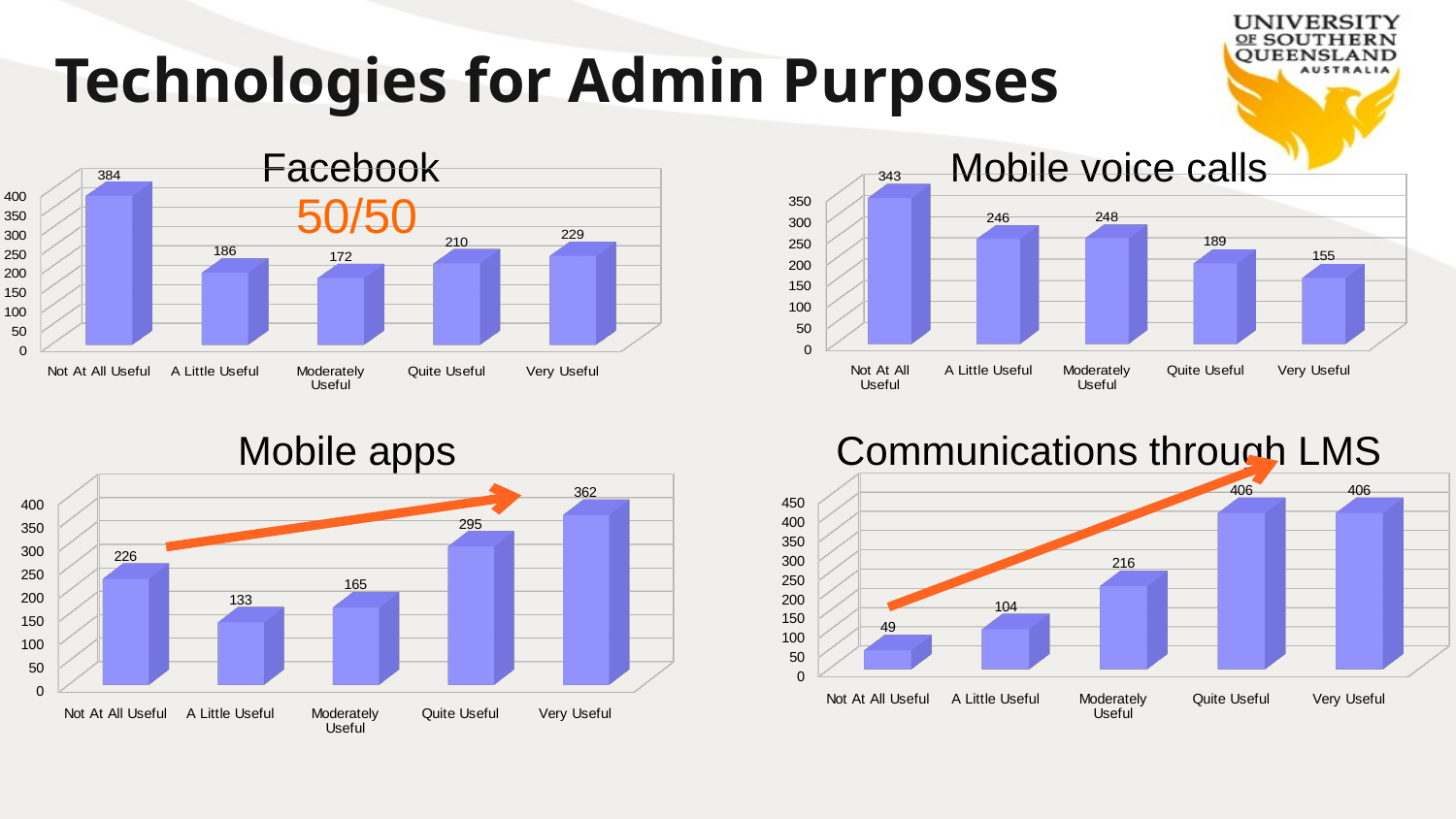
In the Communications through LMS chart, what is the difference between Quite Useful and Moderately Useful? 190 How many categories does the Mobile apps chart show? 5 In the Mobile voice calls chart, what is the value for Very Useful? 155 In the Mobile apps chart, what is the value for A Little Useful? 133 In the Facebook chart, what is the value for Not At All Useful? 384 In the Communications through LMS chart, which is larger, Moderately Useful or A Little Useful? Moderately Useful In the Mobile voice calls chart, do the values generally rise or fall from Not At All Useful to Very Useful? fall In the Mobile apps chart, which category has the highest value? Very Useful In the Mobile voice calls chart, what is the difference between Not At All Useful and Very Useful? 188 In the Facebook chart, which category has the lowest value? Moderately Useful In the Communications through LMS chart, what is the value for Not At All Useful? 49 What kind of chart is the Facebook chart? bar chart